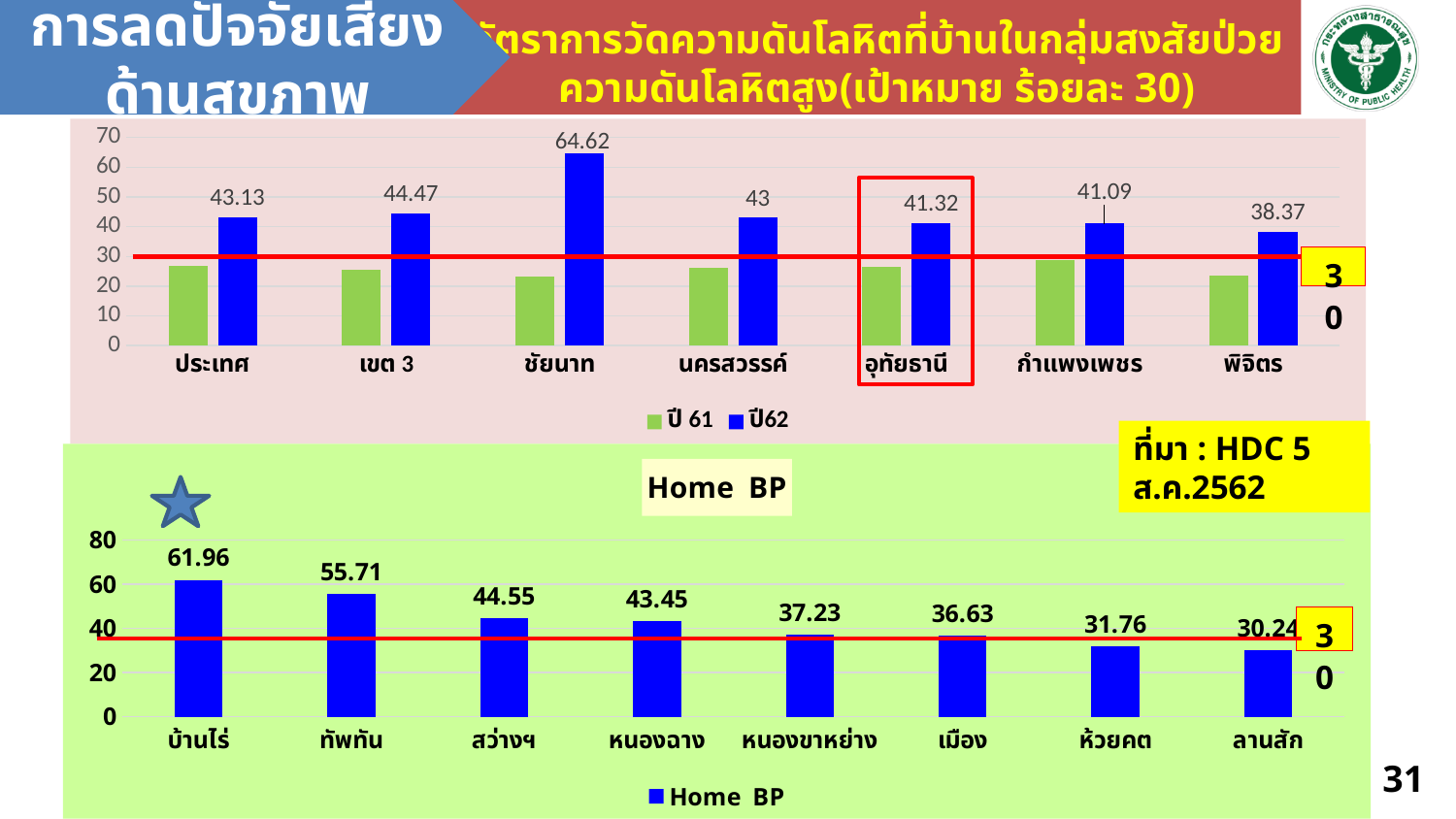
In the top chart, what is the ปี62 value for อุทัยธานี? 41.32 In the top chart, is the ปี 61 value for กำแพงเพชร greater or less than 30? less In the top chart, what is the difference between the ปี62 values for ชัยนาท and พิจิตร? 26.25 What kind of chart is the Home BP chart? bar chart In the top chart, which category has the highest ปี62 value? ชัยนาท In the top chart, how many series does the legend list? 2 In the Home BP chart, how many categories are shown on the x axis? 8 In the Home BP chart, what is the value for ทัพทัน? 55.71 In the Home BP chart, do the values rise or fall from left to right along the x axis? fall In the top chart, which category has the lowest ปี62 value? พิจิตร In the top chart, what is the ปี62 value for ชัยนาท? 64.62 In the Home BP chart, which category has the lowest value? ลานสัก